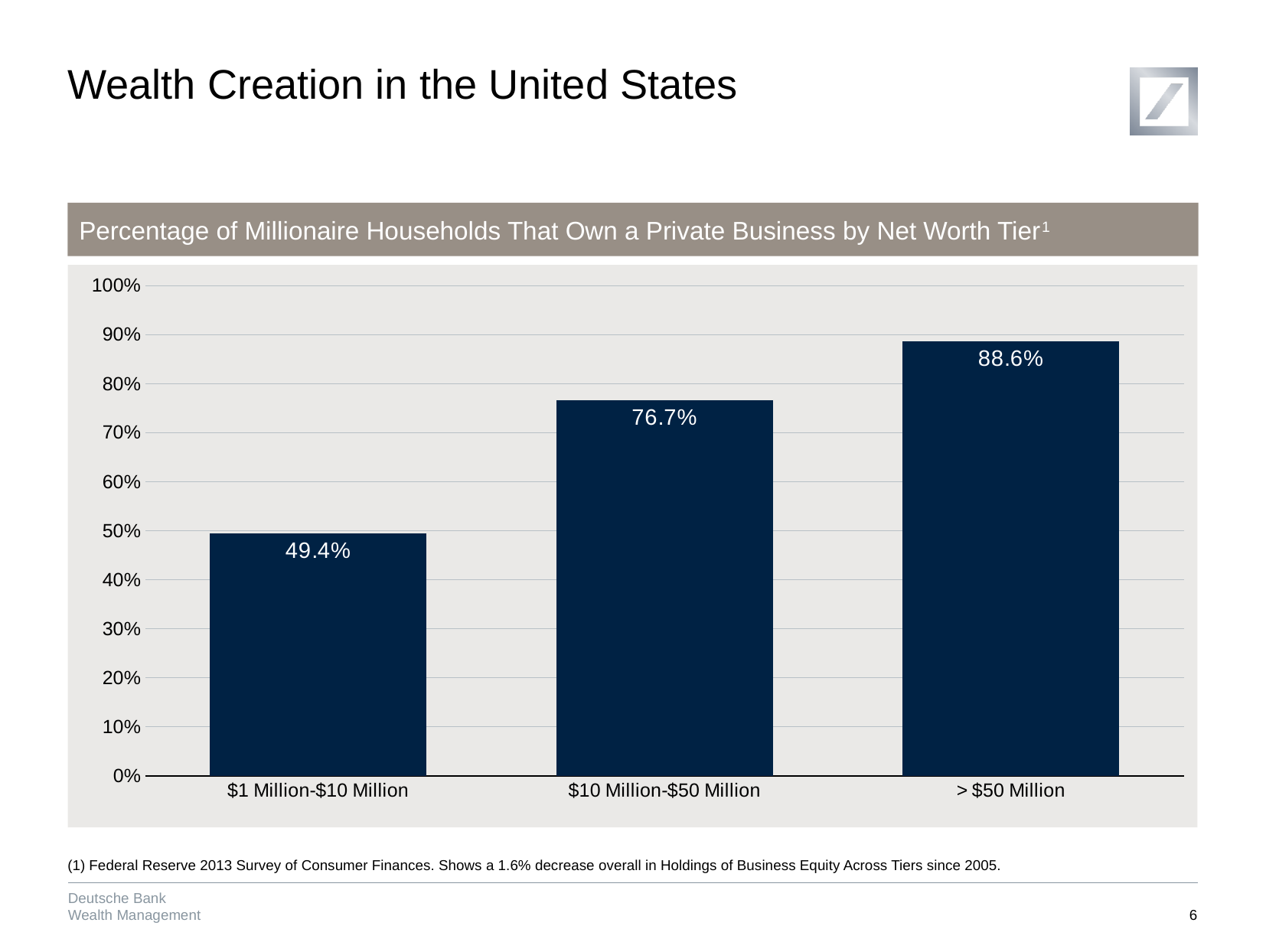
Which net worth tier has the lowest percentage of households owning a private business? $1 Million-$10 Million Is the value for the $1 Million-$10 Million tier greater or less than 50%? less What percentage of millionaire households in the $1 Million-$10 Million net worth tier own a private business? 49.4% How many net worth tiers are shown in the chart? 3 What is the difference between the $10 Million-$50 Million tier and the $1 Million-$10 Million tier? 27.3% What is the difference between the > $50 Million tier and the $1 Million-$10 Million tier? 39.2% What is the value shown for the > $50 Million tier? 88.6% Do the values rise or fall as net worth tier increases from left to right? Rise Which net worth tier has the highest percentage of households owning a private business? > $50 Million Which is larger, the value for $10 Million-$50 Million or the value for > $50 Million? > $50 Million What is the value shown for the $10 Million-$50 Million tier? 76.7% What kind of chart is shown on the slide? Bar chart